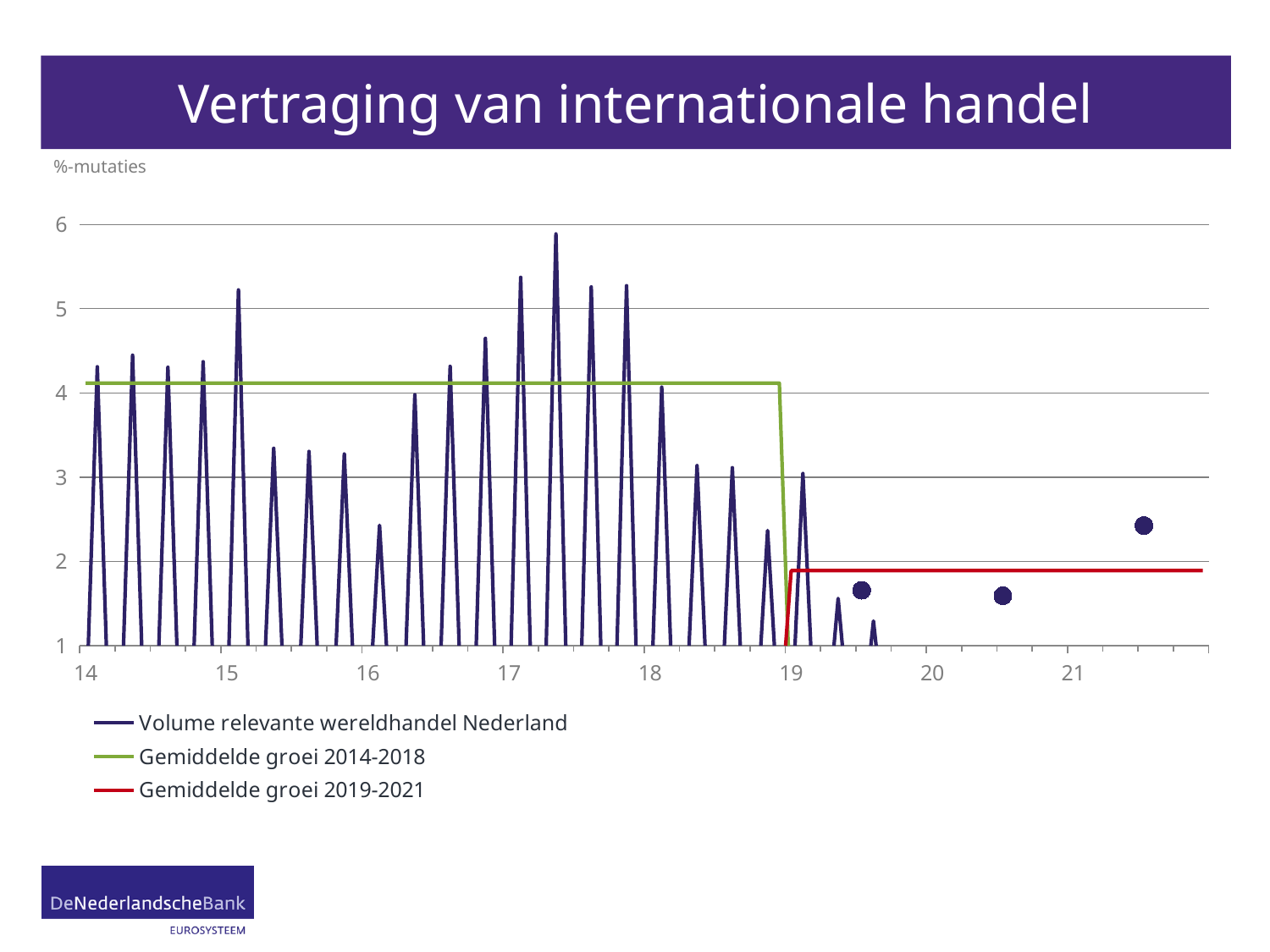
What kind of chart is shown on the slide? line chart Which series is drawn in green according to the legend? Gemiddelde groei 2014-2018 Does the average growth line fall or rise when moving from the 2014-2018 period to the 2019-2021 period? fall What unit label is shown above the y axis? %-mutaties Is the highest peak of the Volume relevante wereldhandel Nederland series greater or less than 5? greater Is the value of the Gemiddelde groei 2019-2021 line greater or less than 2? less Is the value of the Gemiddelde groei 2014-2018 line greater or less than 4? greater How many series does the legend list? 3 Which is higher: the Gemiddelde groei 2014-2018 line or the Gemiddelde groei 2019-2021 line? Gemiddelde groei 2014-2018 What is the title of the chart? Vertraging van internationale handel